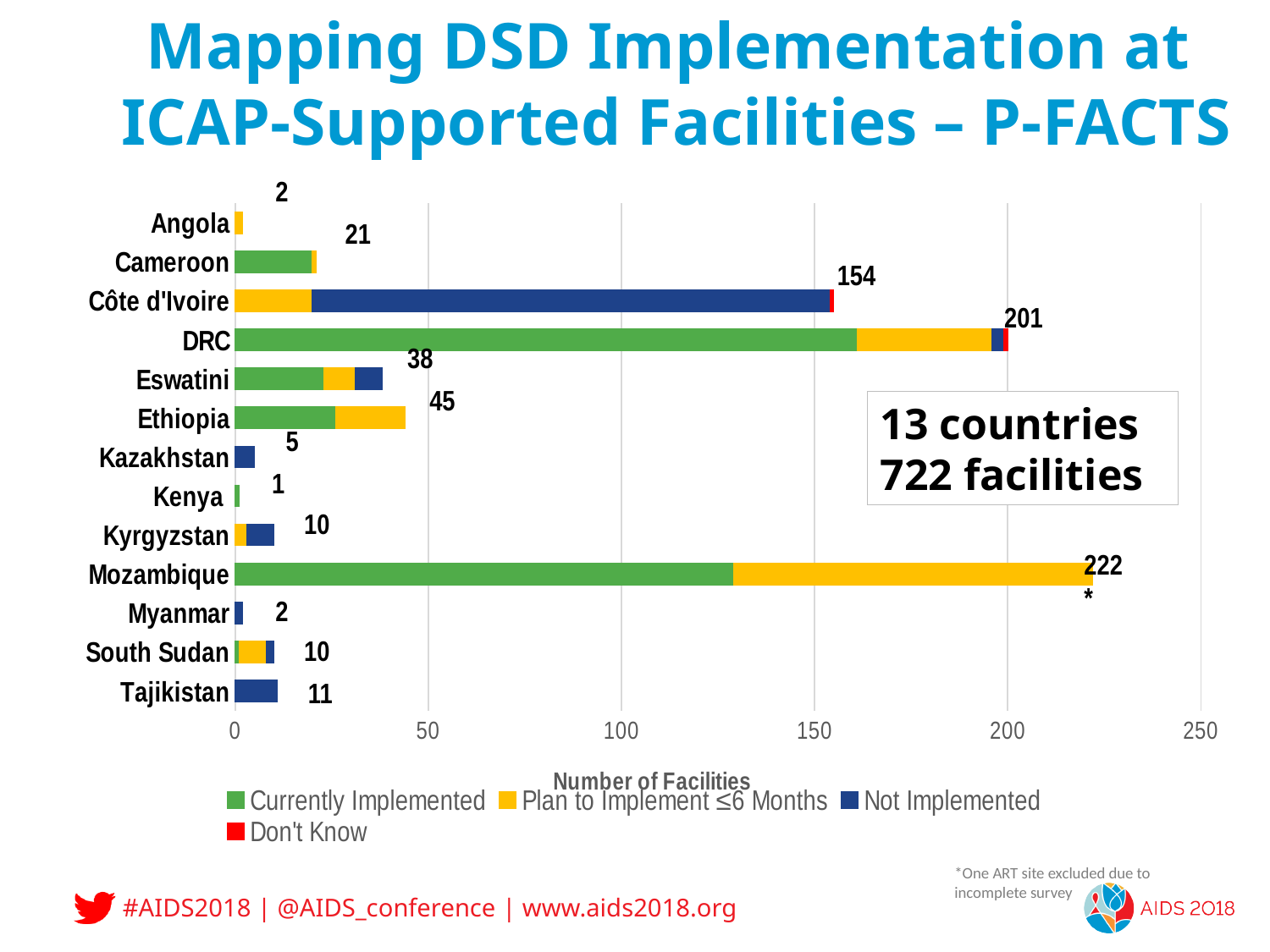
Which has a larger total number of facilities, Côte d'Ivoire or DRC? DRC What is the total number of facilities shown for Mozambique? 222 How many countries are listed on the chart's vertical axis? 13 Which country has the lowest total number of facilities? Kenya Is the Currently Implemented value for DRC greater or less than 150? greater What is the label of the horizontal axis? Number of Facilities What is the difference between the total facilities for Mozambique and DRC? 21 What is the total number of facilities shown for Côte d'Ivoire? 154 Which country has the highest total number of facilities? Mozambique What is the total number of facilities shown for Eswatini? 38 How many series does the legend list? 4 What kind of chart is shown on the slide? bar chart